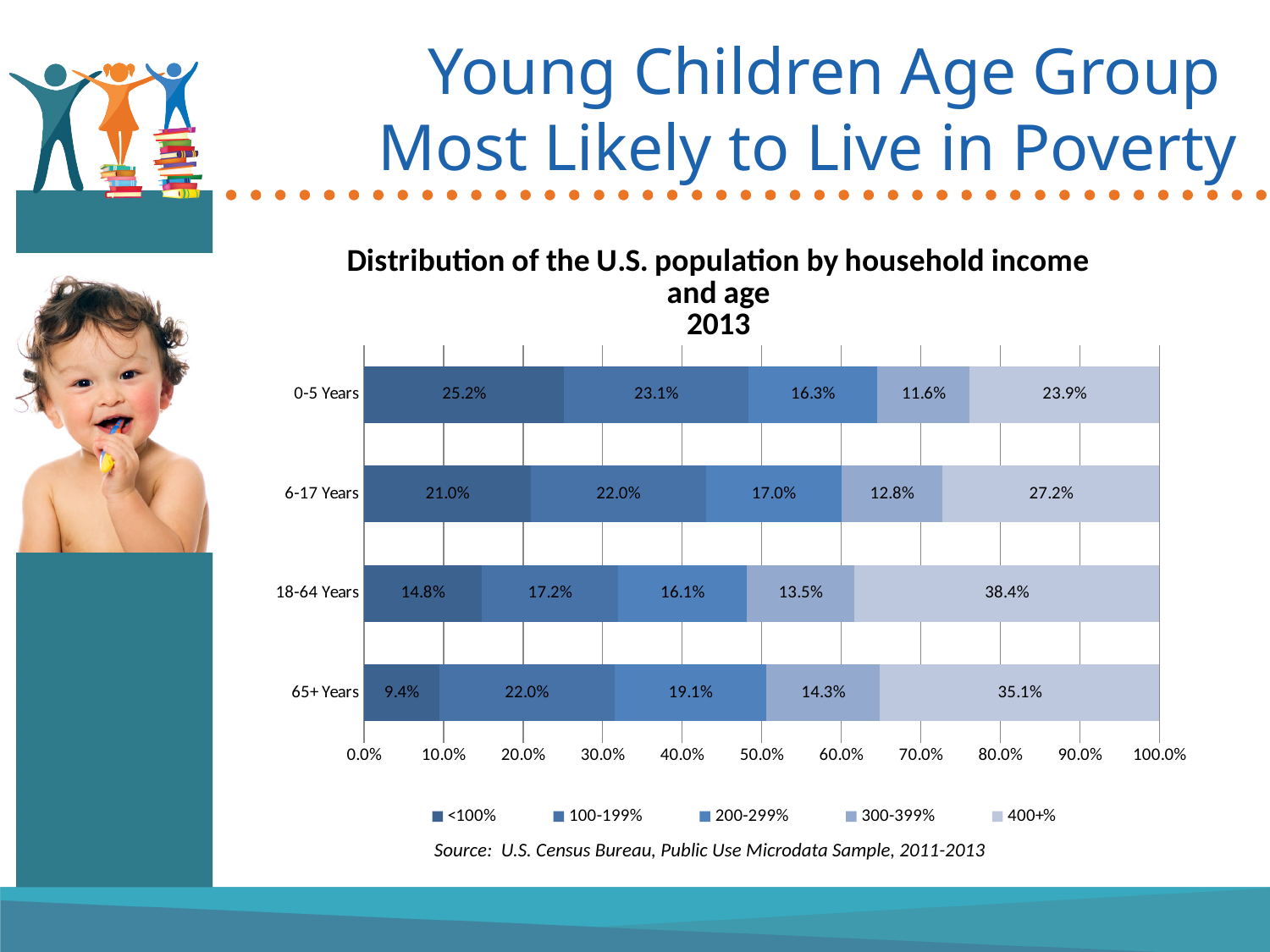
Which age group has the highest <100% share? 0-5 Years How many age groups are shown on the chart? 4 What percentage of the 0-5 Years age group has household income below 100% of poverty (<100%)? 25.2% Which age group has the lowest <100% share? 65+ Years What kind of chart is shown on the slide? Stacked bar chart What is the title of the chart? Distribution of the U.S. population by household income and age 2013 Which is larger: the 400+% share for 6-17 Years or for 65+ Years? 65+ Years What is the 400+% value for the 18-64 Years age group? 38.4% How many series does the legend list? 5 What is the 200-299% value for the 65+ Years age group? 19.1% What is the difference between the <100% share for 0-5 Years and for 65+ Years? 15.8% What is the combined share of <100% and 100-199% for the 6-17 Years age group? 43.0%